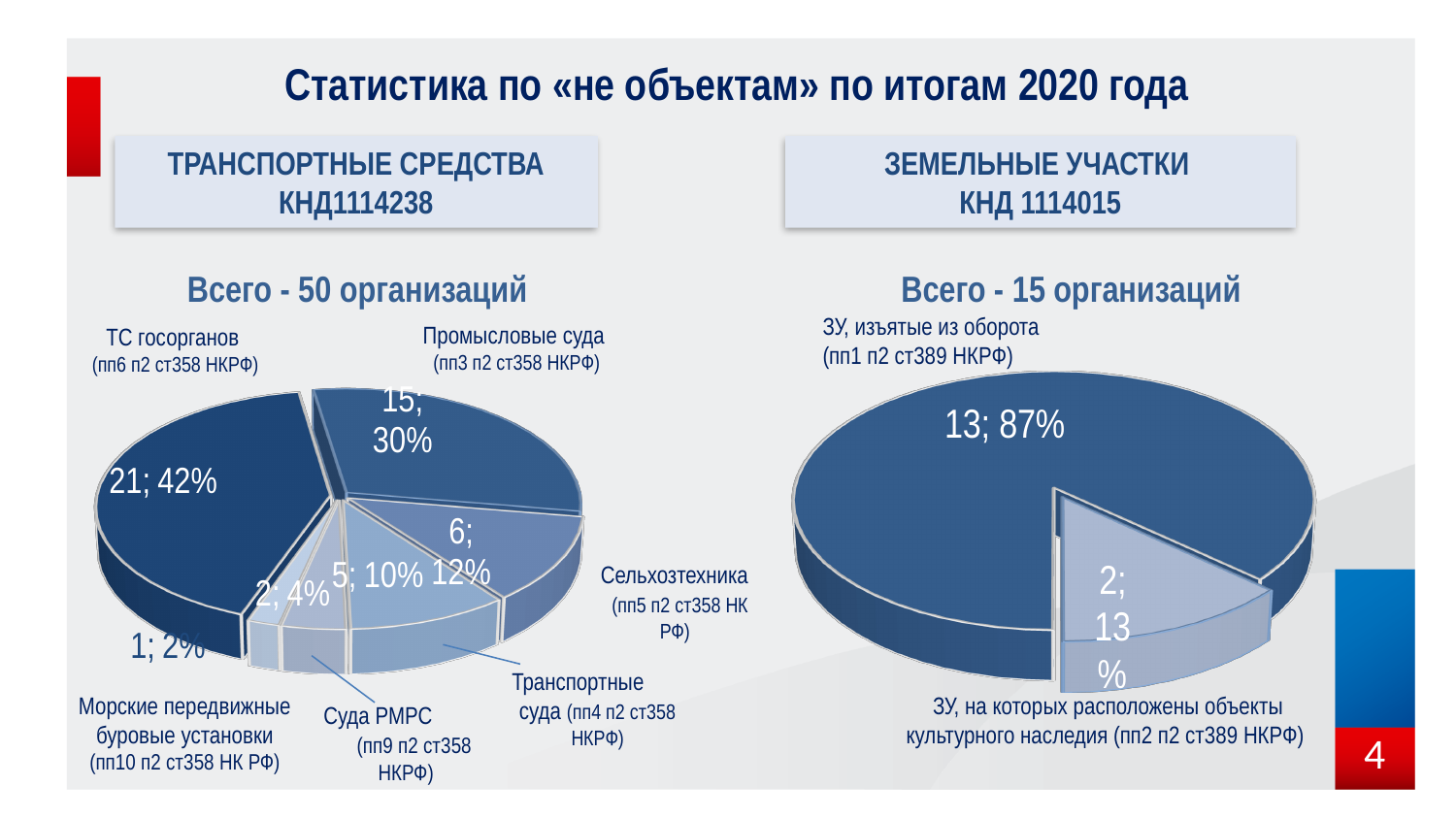
On the left chart (Транспортные средства), what share of the pie does Сельхозтехника take? 12% On the left chart (Транспортные средства), what is the value for ТС госорганов? 21; 42% What type of chart is used on the left chart (Транспортные средства)? Pie chart On the right chart (Земельные участки), what share of the pie do ЗУ, на которых расположены объекты культурного наследия take? 13% On the left chart (Транспортные средства), which category has the smallest slice? Морские передвижные буровые установки What total number of organisations is stated above the right chart (Земельные участки)? 15 организаций On the left chart (Транспортные средства), which is larger: Транспортные суда or Суда РМРС? Транспортные суда On the right chart (Земельные участки), what is the value for ЗУ, изъятые из оборота? 13; 87% On the left chart (Транспортные средства), which category has the largest slice? ТС госорганов On the left chart (Транспортные средства), how many categories are shown? 6 On the left chart (Транспортные средства), what is the value for Промысловые суда? 15; 30% On the left chart (Транспортные средства), what is the difference in count between ТС госорганов and Промысловые суда? 6